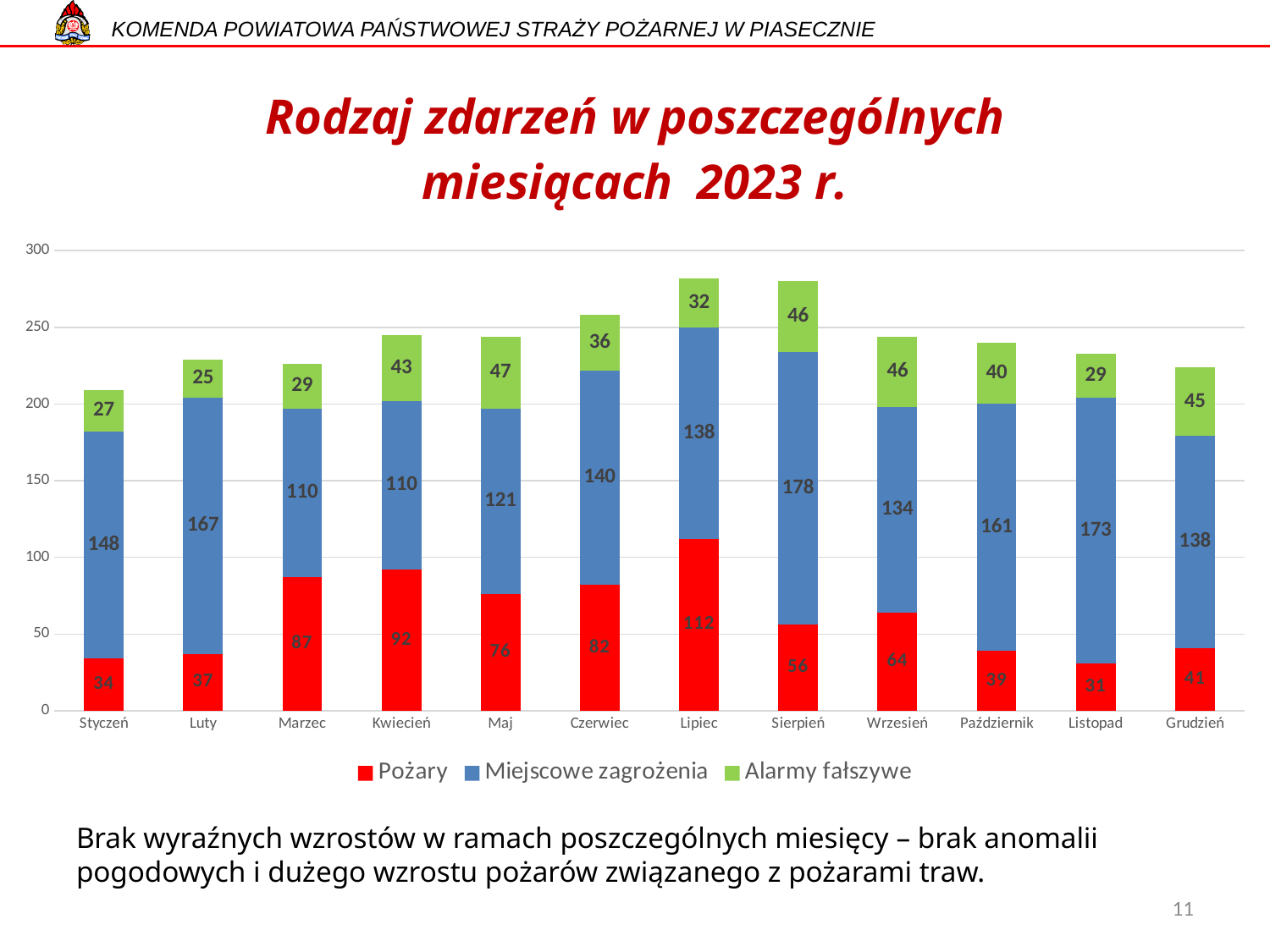
Which is larger: the Pożary value for Kwiecień or for Wrzesień? Kwiecień What is the value of Miejscowe zagrożenia for Sierpień? 178 What is the total of the stacked bar for Styczeń? 209 How many months (categories) are shown on the x axis? 12 Which month has the lowest value for Alarmy fałszywe? Luty What is the difference between the Miejscowe zagrożenia values for Listopad and Marzec? 63 Which month has the highest value for Pożary? Lipiec What is the value of Pożary for Lipiec? 112 Which series is shown in red in the legend? Pożary How many series does the legend list? 3 What is the value of Alarmy fałszywe for Grudzień? 45 What type of chart is shown on the slide? Stacked bar chart